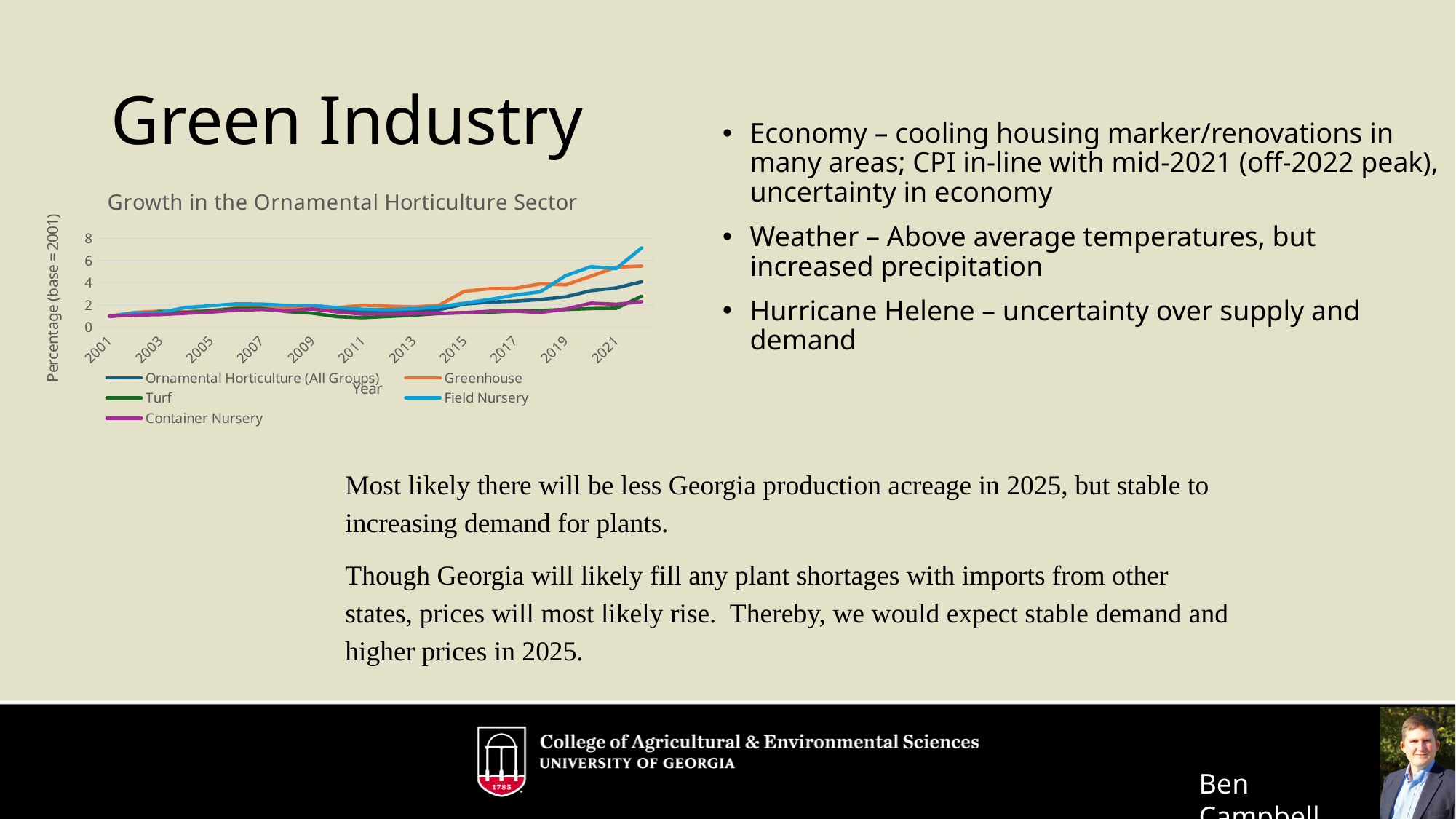
What is the title of the chart? Growth in the Ornamental Horticulture Sector What is the label on the vertical axis of the chart? Percentage (base = 2001) Is the final value of the Field Nursery series greater or less than 6? greater Which series has the lowest value around 2011? Turf How many series does the chart legend list? 5 Is the final value of the Greenhouse series greater or less than 4? greater At the right end of the chart, which is larger: Field Nursery or Turf? Field Nursery Which series has the highest value at the right end of the chart? Field Nursery Is the value of the Turf series around 2011 greater or less than 2? less Does the Field Nursery series generally rise or fall from 2001 to the end of the chart? rise How many year labels are shown on the x axis? 11 What kind of chart is shown on the slide? line chart